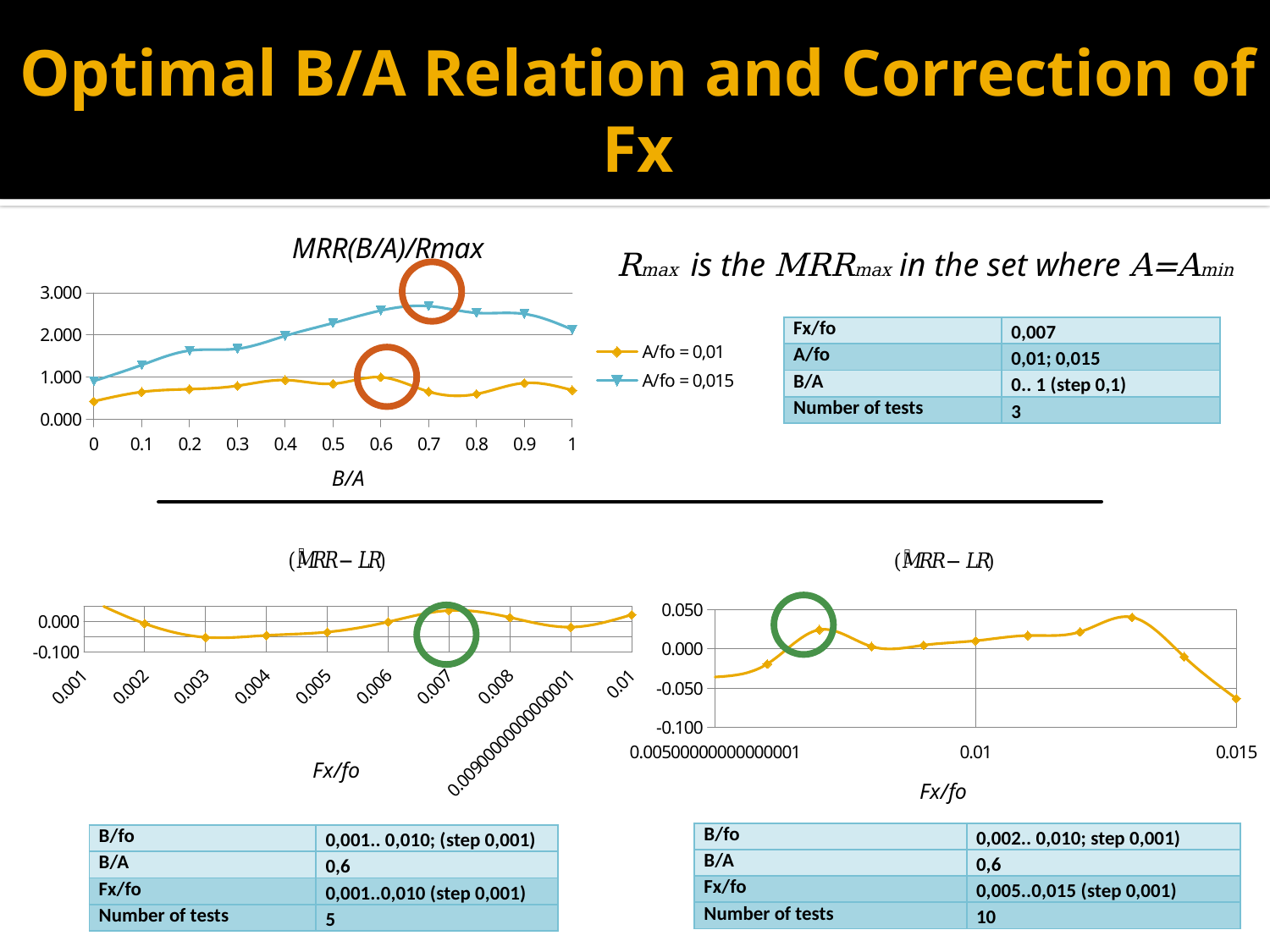
In the bottom-left (MRR − LR) chart, is the value at Fx/fo = 0.003 greater or less than 0.000? less What is the x-axis title of the MRR(B/A)/Rmax chart? B/A In the MRR(B/A)/Rmax chart, is the value of A/fo = 0,01 at B/A = 0 greater or less than 1.000? less In the MRR(B/A)/Rmax chart, which series has the higher value at B/A = 0.5? A/fo = 0,015 What kind of chart is the top-left chart titled MRR(B/A)/Rmax? line chart In the bottom-right (MRR − LR) chart, is the value at Fx/fo = 0.015 greater or less than -0.050? less What kind of chart is the bottom-left (MRR − LR) chart? line chart What is the x-axis title of the bottom-right (MRR − LR) chart? Fx/fo How many series does the legend of the MRR(B/A)/Rmax chart list? 2 In the MRR(B/A)/Rmax chart, how many B/A points are plotted for each series? 11